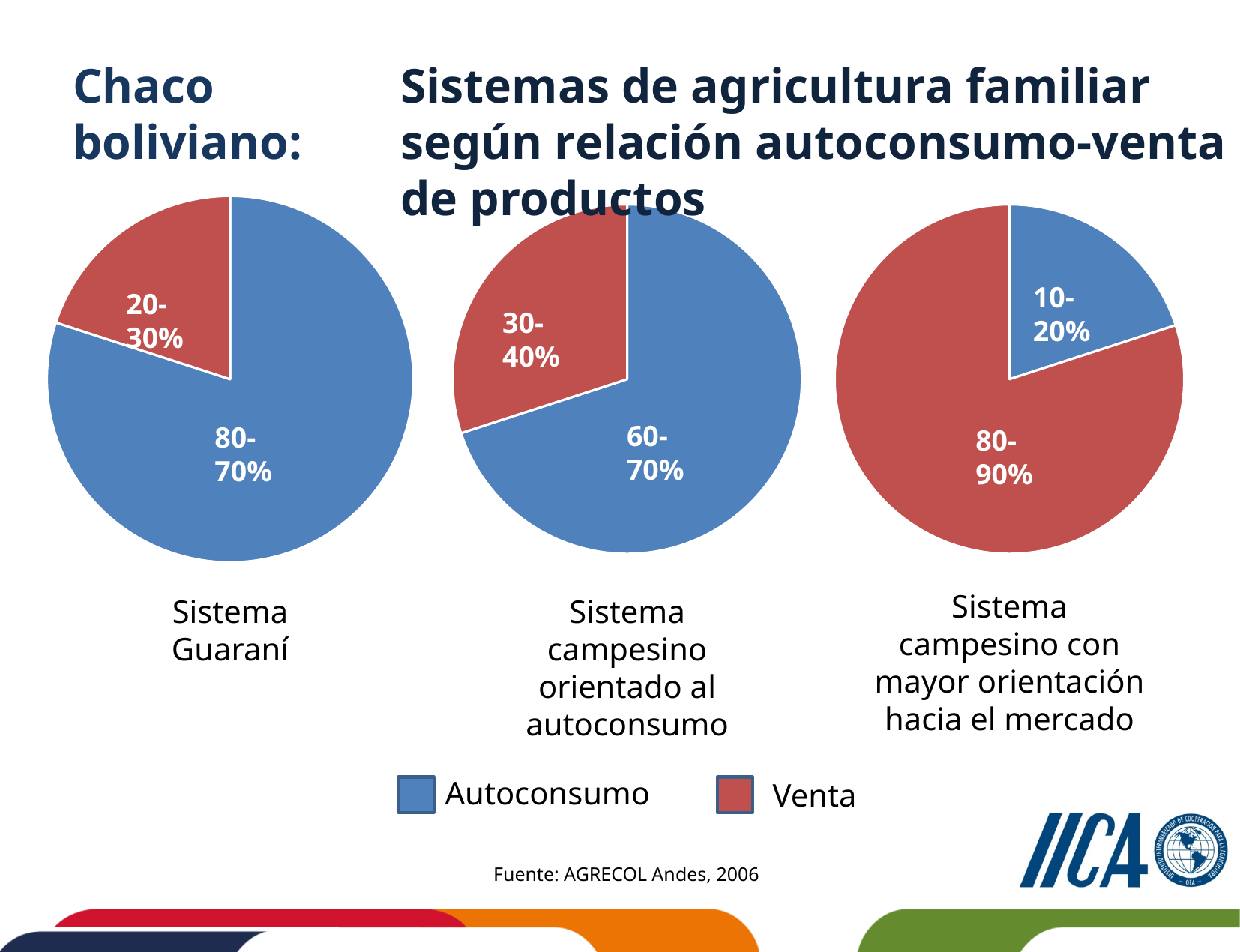
In the Sistema campesino orientado al autoconsumo pie chart, what is the label on the Venta slice? 30-40% In the Sistema campesino orientado al autoconsumo pie chart, which slice is the smallest? Venta In the Sistema Guaraní pie chart, which slice is larger, Autoconsumo or Venta? Autoconsumo In the Sistema campesino con mayor orientación hacia el mercado pie chart, which slice is the largest? Venta In the Sistema campesino orientado al autoconsumo pie chart, what is the label on the Autoconsumo slice? 60-70% Which colour represents Venta in the legend? Red In the Sistema Guaraní pie chart, what is the label shown on the Venta slice? 20-30% How many series does the legend list? 2 What type of chart is used on this slide? Pie chart In the Sistema campesino con mayor orientación hacia el mercado pie chart, what is the label on the Venta slice? 80-90% In the Sistema Guaraní pie chart, what is the label shown on the Autoconsumo slice? 80-70% In the Sistema campesino con mayor orientación hacia el mercado pie chart, what is the label on the Autoconsumo slice? 10-20%